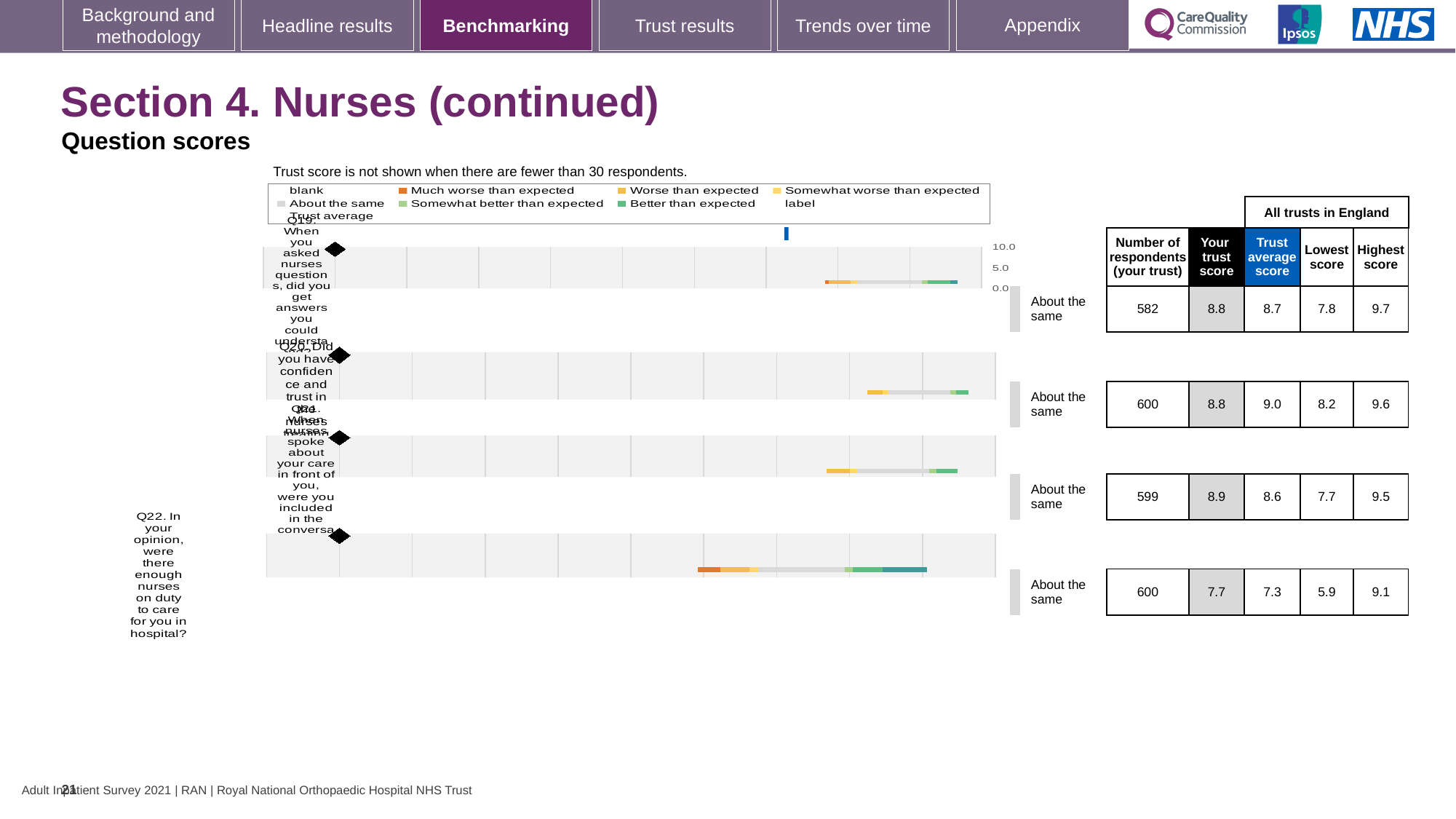
What benchmark category is shown next to the bar for Q22? About the same For Q22, what is the difference between 'Your trust score' and the 'Trust average score'? 0.4 For Q20, which is larger: 'Your trust score' or the 'Trust average score'? Trust average score Which question has the highest 'Your trust score'? Q21 What kind of chart is used to show the question scores on this slide? bar chart How many respondents from your trust answered Q22? 600 How many questions (rows) are plotted in the chart? 4 What is the 'Your trust score' for Q22 (were there enough nurses on duty to care for you in hospital)? 7.7 Which question has the lowest 'Your trust score'? Q22 What is the lowest score across all trusts in England for Q21? 7.7 What is the highest score across all trusts in England for Q19? 9.7 What is the 'Trust average score' for Q19? 8.7